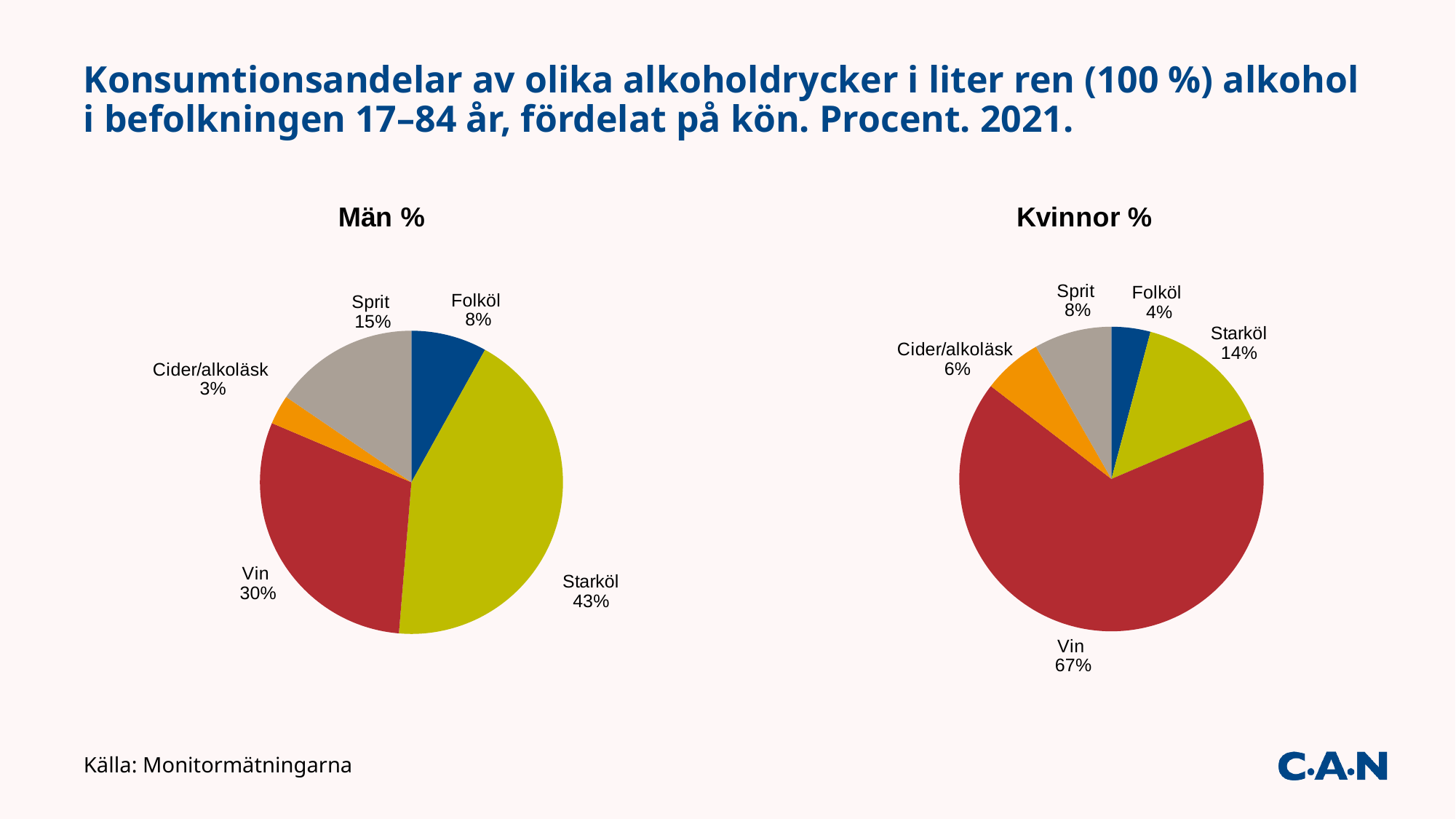
In the 'Män %' pie chart, what is the difference between the shares for Starköl and Vin? 13 percentage points What colour is the Vin slice in the 'Kvinnor %' pie chart? Red Is the share for Sprit larger in the 'Män %' pie chart or the 'Kvinnor %' pie chart? Män % In the 'Män %' pie chart, what is the share for Cider/alkoläsk? 3% In the 'Kvinnor %' pie chart, which category has the smallest share? Folköl In the 'Män %' pie chart, what is the share for Starköl? 43% In the 'Kvinnor %' pie chart, what is the difference between the shares for Vin and Starköl? 53 percentage points In the 'Kvinnor %' pie chart, what is the share for Sprit? 8% In the 'Män %' pie chart, which category has the largest share? Starköl In the 'Kvinnor %' pie chart, what is the share for Vin? 67% What type of chart is used for 'Män %'? Pie chart How many categories are shown in the 'Kvinnor %' pie chart? 5